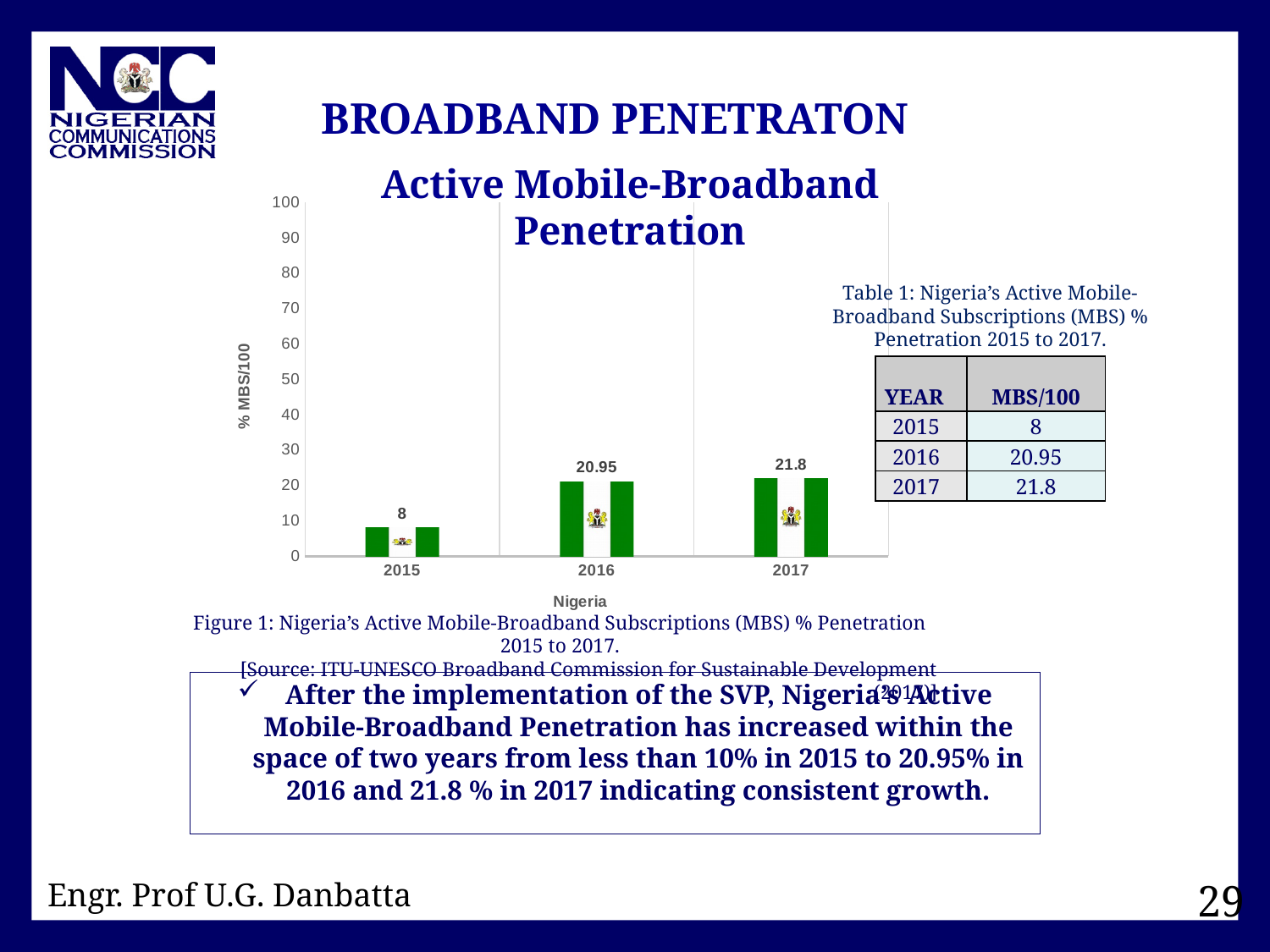
What is the difference between the 2017 and 2016 values in the Active Mobile-Broadband Penetration chart? 0.85 What is the value for 2015 in the Active Mobile-Broadband Penetration chart? 8 Do the values in the Active Mobile-Broadband Penetration chart rise or fall from 2015 to 2017? Rise Which year has the highest value in the Active Mobile-Broadband Penetration chart? 2017 Which year has the lowest value in the Active Mobile-Broadband Penetration chart? 2015 What is the difference between the 2016 and 2015 values in the Active Mobile-Broadband Penetration chart? 12.95 What is the value for 2016 in the Active Mobile-Broadband Penetration chart? 20.95 How many years are shown on the x axis of the Active Mobile-Broadband Penetration chart? 3 What is the value for 2017 in the Active Mobile-Broadband Penetration chart? 21.8 Is the value for 2015 greater or less than 10 in the Active Mobile-Broadband Penetration chart? less What kind of chart is the Active Mobile-Broadband Penetration chart? Bar chart